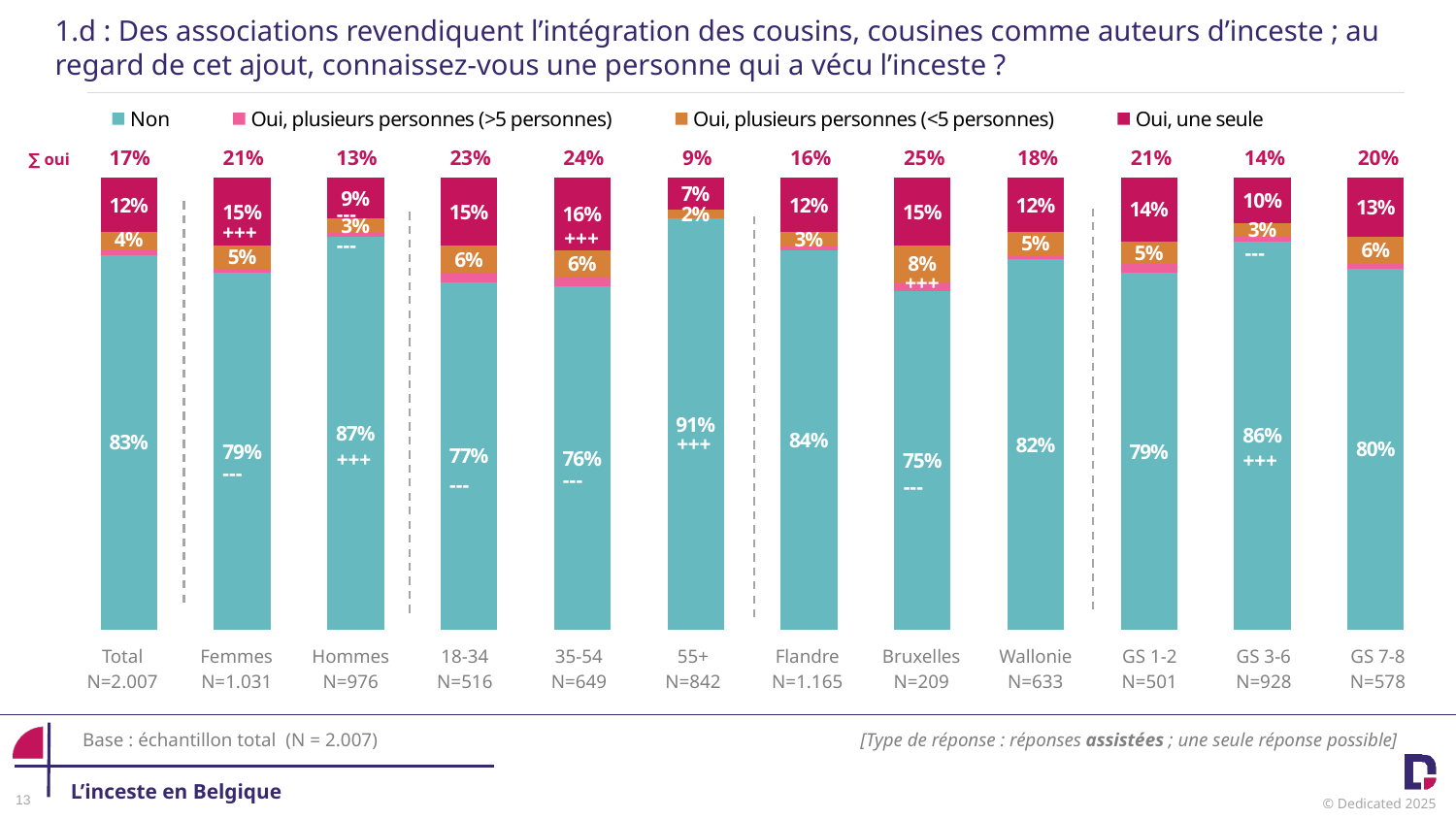
What is the '∑ oui' value for Bruxelles? 25% What is the difference between the 'Non' values for Hommes and Femmes? 8% What is the value of 'Non' for the Total category? 83% What is the value of 'Oui, plusieurs personnes (<5 personnes)' for Bruxelles? 8% What type of chart is shown on the slide? stacked bar chart What is the sample size (N) shown for the Wallonie category? N=633 Which category has the lowest '∑ oui' value? 55+ What is the value of 'Oui, une seule' for the 35-54 category? 16% How many series does the legend list? 4 Which has a larger 'Oui, une seule' value, Flandre or Bruxelles? Bruxelles How many categories (bars) are shown on the chart? 12 Which category has the highest 'Non' value? 55+